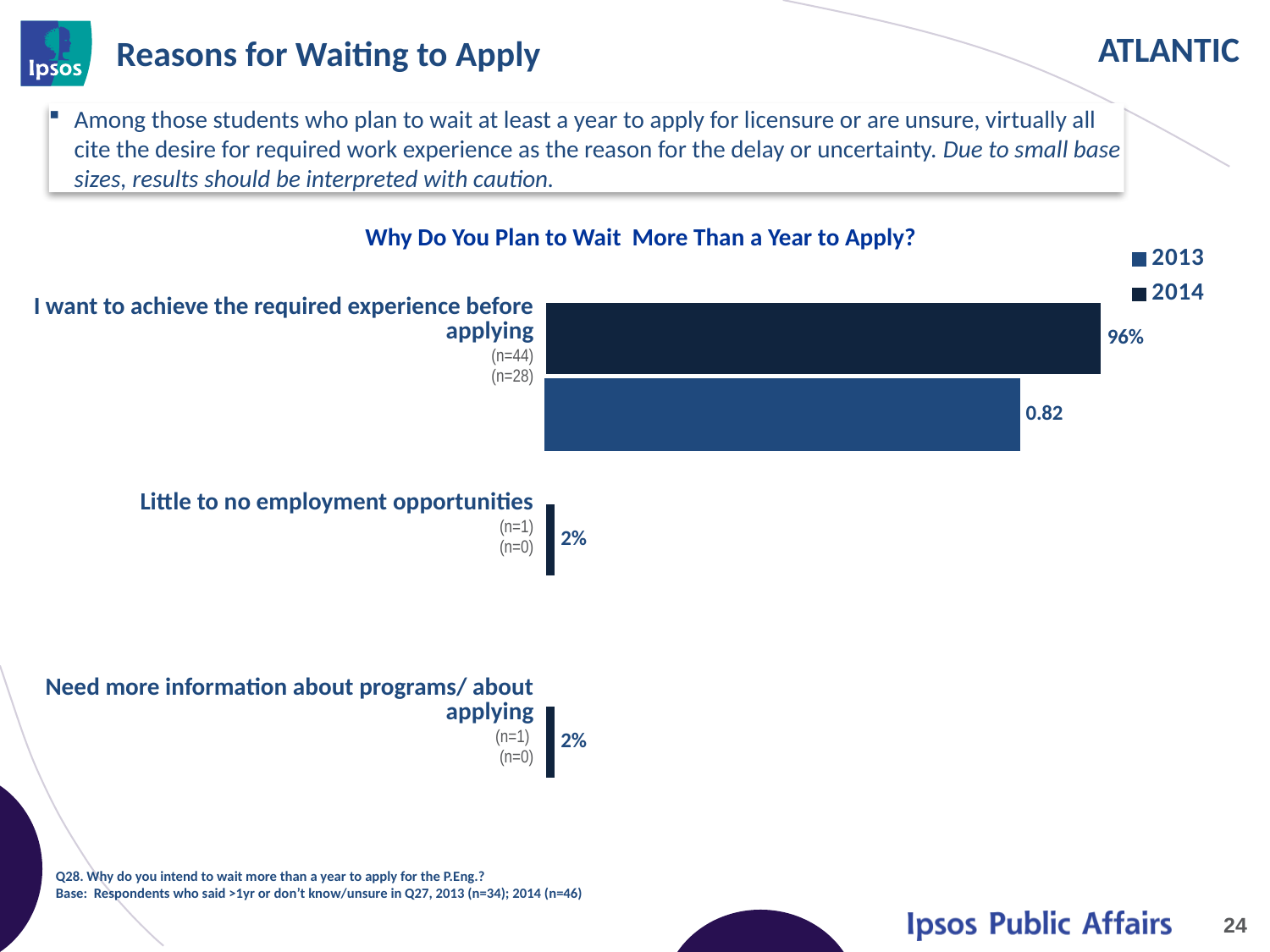
How many reasons (categories) are shown in the chart? 3 What is the title of the chart? Why Do You Plan to Wait More Than a Year to Apply? What kind of chart is shown on the slide? Bar chart Which reason has the highest 2013 value? I want to achieve the required experience before applying For "I want to achieve the required experience before applying", which year has the larger value, 2013 or 2014? 2014 What is the 2014 value for "I want to achieve the required experience before applying"? 96% What is the 2013 value for "I want to achieve the required experience before applying"? 0.82 What are the two entries in the chart's legend? 2013 and 2014 How many series does the legend list? 2